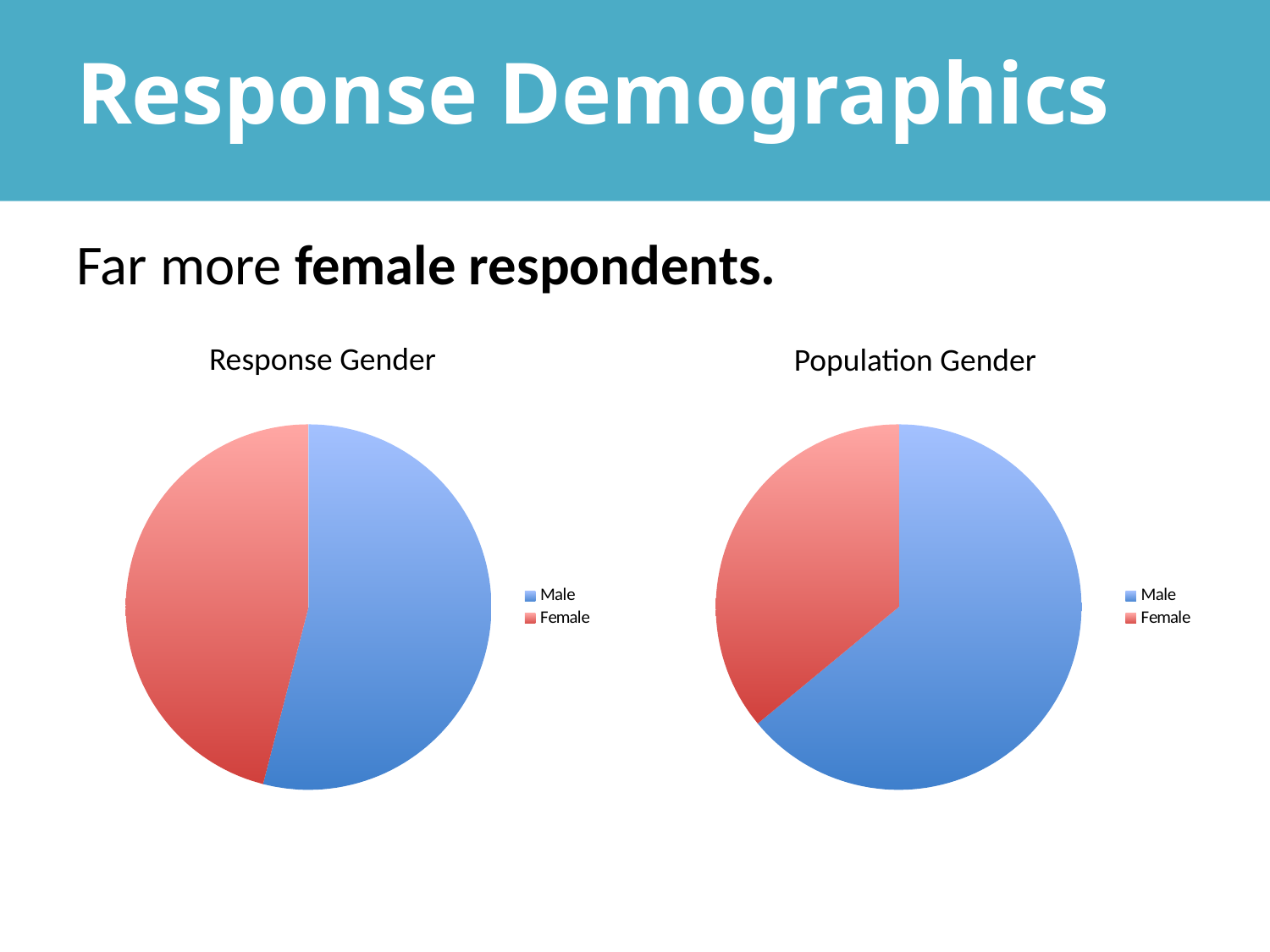
How many entries does the legend of the Population Gender chart list? 2 In the Population Gender chart, which category has the smallest slice? Female In the Response Gender chart, which colour represents Female? red In the Population Gender chart, which category has the largest slice? Male What is the title of the chart on the left of the slide? Response Gender How many charts are shown on the slide? 2 How many slices does the Population Gender pie chart have? 2 What kind of chart is the Response Gender chart? pie chart What kind of chart is the Population Gender chart? pie chart In the Population Gender chart, is the Male slice larger or smaller than the Female slice? larger How many slices does the Response Gender pie chart have? 2